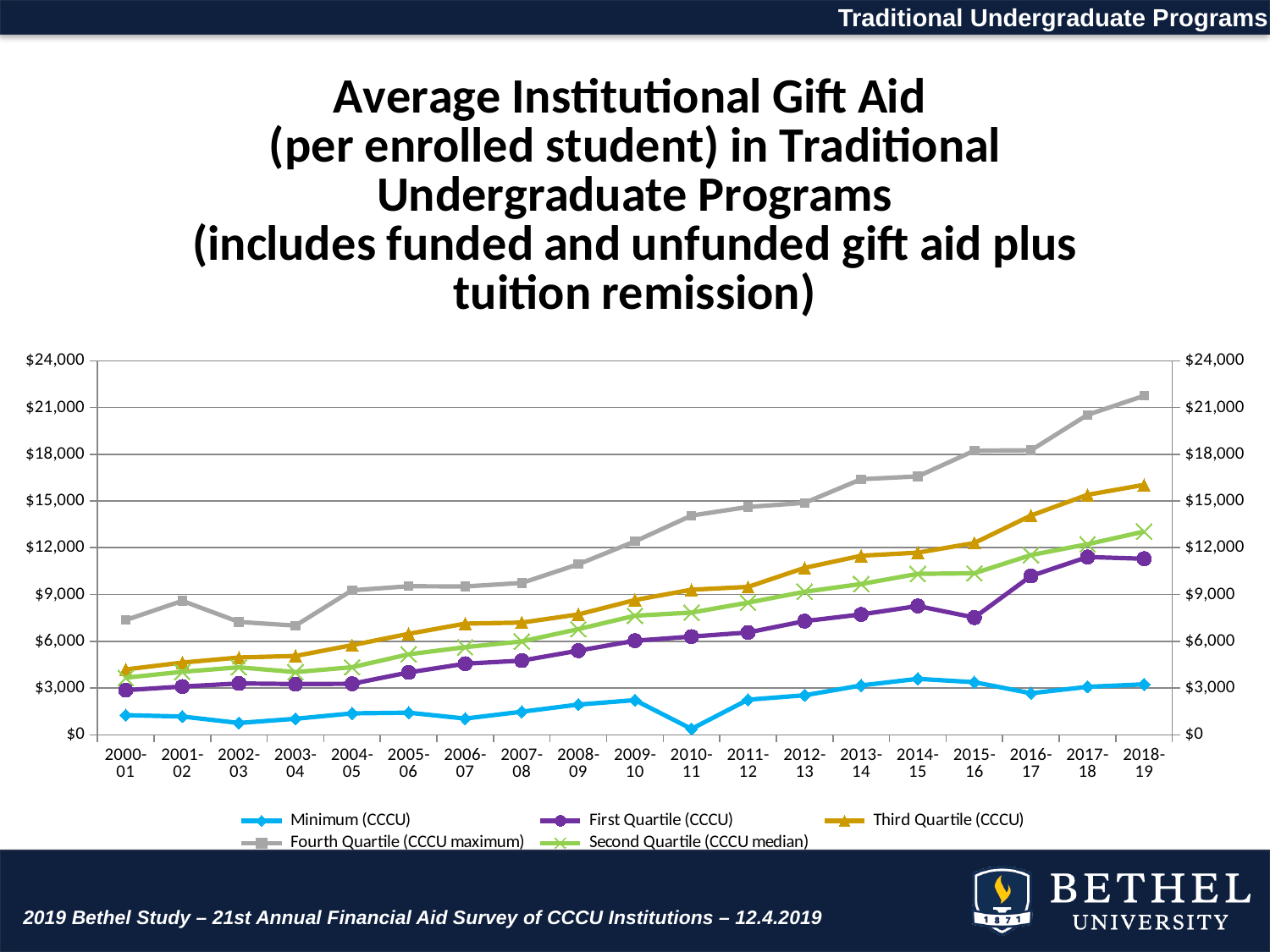
In 2015-16, which is larger: Third Quartile (CCCU) or Second Quartile (CCCU median)? Third Quartile (CCCU) What kind of chart is shown on the slide? Line chart How many academic years are plotted along the x axis? 19 In which year does the Fourth Quartile (CCCU maximum) series reach its highest value? 2018-19 Is the value for Third Quartile (CCCU) in 2018-19 greater or less than $15,000? greater Which series has the highest value in 2018-19? Fourth Quartile (CCCU maximum) Is the value for Fourth Quartile (CCCU maximum) in 2018-19 greater or less than $21,000? greater Does the Fourth Quartile (CCCU maximum) series generally rise or fall from 2000-01 to 2018-19? Rise How many series does the legend list? 5 Is the value for Minimum (CCCU) in 2010-11 greater or less than $3,000? less In which year does the Minimum (CCCU) series reach its lowest value? 2010-11 Which series has the lowest value in 2018-19? Minimum (CCCU)